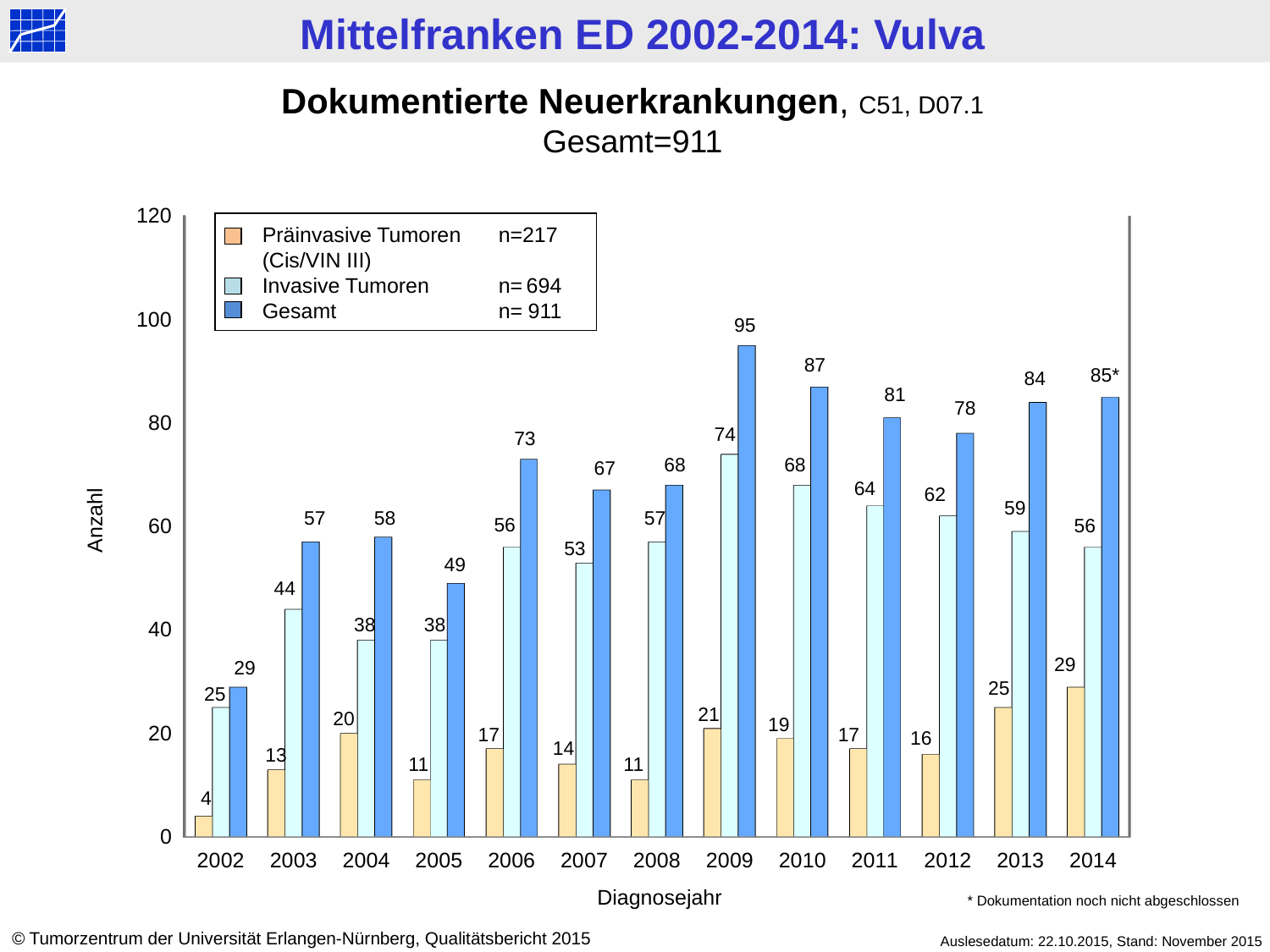
Which year has the lowest value for Invasive Tumoren? 2002 Which year has the highest Gesamt value? 2009 How many diagnosis years are shown on the x axis? 13 Is the Gesamt value for 2006 greater or less than 80? less What is the Gesamt value for 2009? 95 What is the value for Präinvasive Tumoren (Cis/VIN III) in 2002? 4 What is the value for Invasive Tumoren in 2010? 68 What is the difference between the Gesamt values for 2009 and 2002? 66 According to the legend, what is the n value for Invasive Tumoren? n= 694 What kind of chart is shown on the slide? bar chart Which is larger, the Präinvasive Tumoren value for 2013 or for 2014? 2014 How many series does the legend list? 3